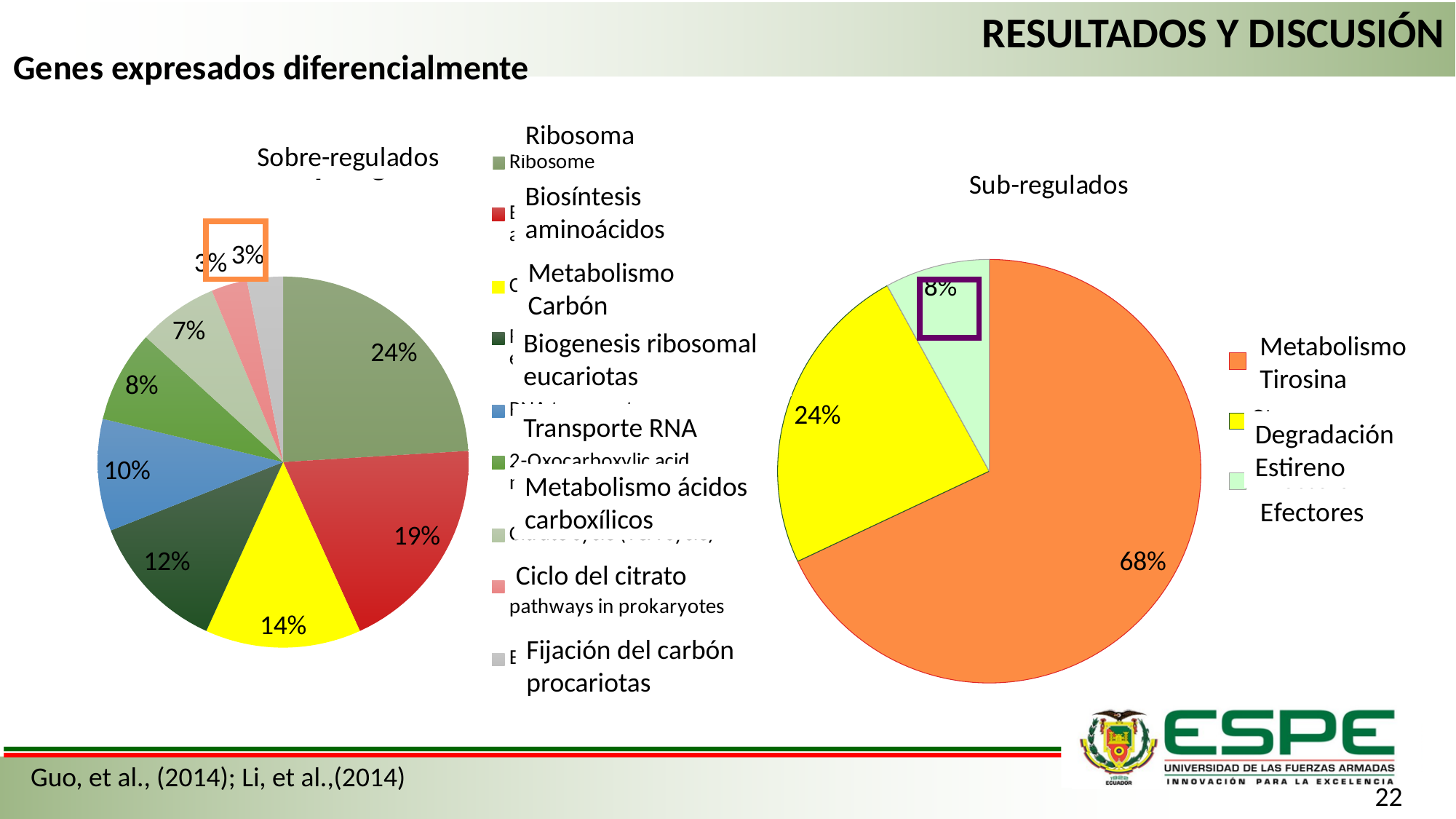
In the Sobre-regulados pie chart, how many slices are there? 9 In the Sobre-regulados pie chart, what percentage is shown for Ribosoma? 24% In the Sub-regulados pie chart, what percentage is shown for Metabolismo Tirosina? 68% In the Sobre-regulados pie chart, what percentage is shown for Biosíntesis aminoácidos? 19% What kind of charts are shown on the slide? Pie charts In the Sobre-regulados pie chart, which is larger, the Transporte RNA slice or the Biogenesis ribosomal eucariotas slice? Biogenesis ribosomal eucariotas In the Sub-regulados pie chart, what percentage is shown for Degradación Estireno? 24% In the Sobre-regulados pie chart, what percentage is shown for Metabolismo Carbón? 14% In the Sub-regulados pie chart, what is the difference between the Metabolismo Tirosina and Degradación Estireno percentages? 44% In the Sub-regulados pie chart, what percentage is shown for Efectores? 8% In the Sub-regulados pie chart, which category has the largest slice? Metabolismo Tirosina In the Sub-regulados pie chart, how many slices are there? 3